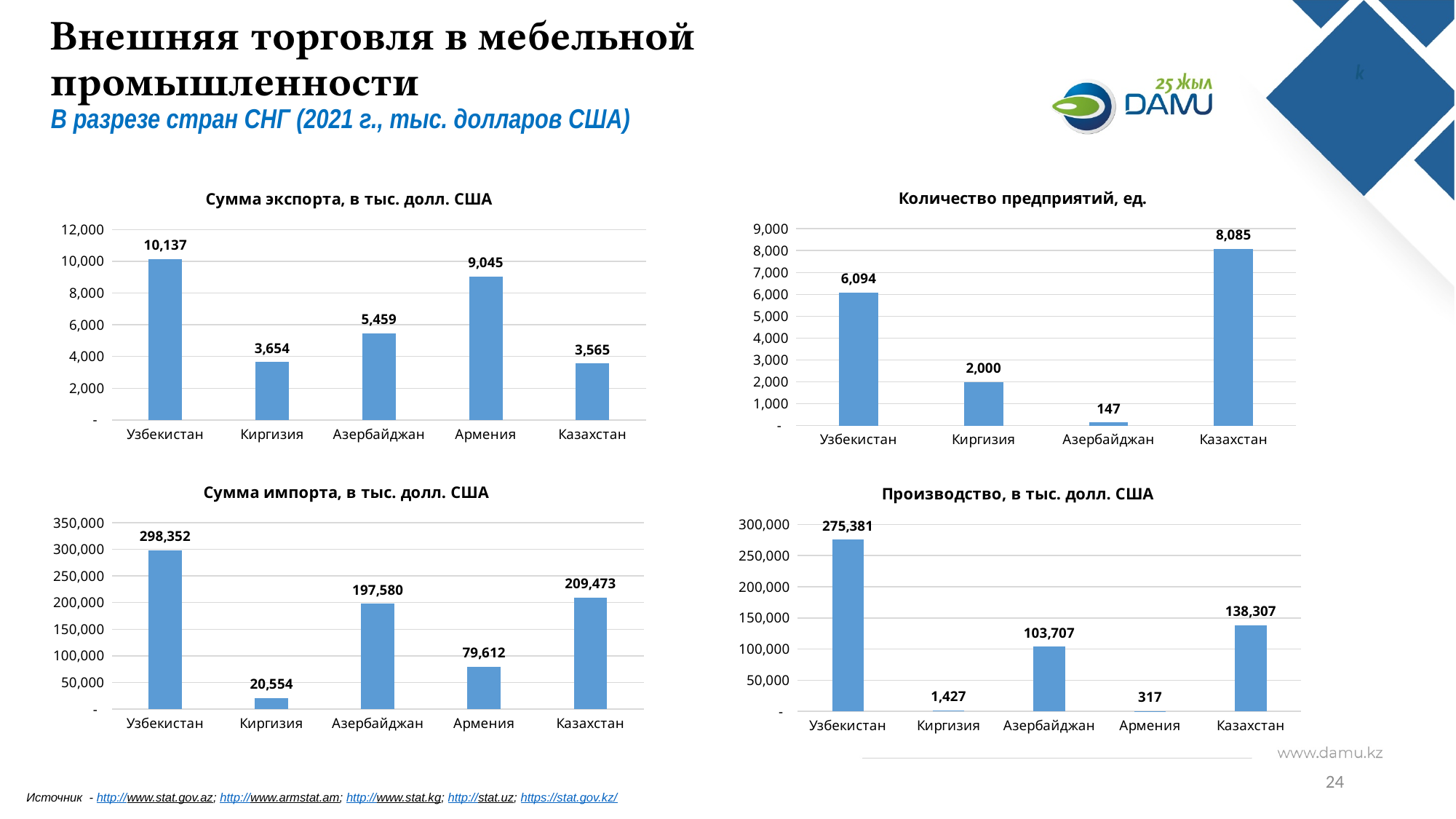
In the chart 'Сумма импорта, в тыс. долл. США', which is larger, the value for Армения or the value for Киргизия? Армения In the chart 'Количество предприятий, ед.', which country has the highest value? Казахстан In the chart 'Сумма импорта, в тыс. долл. США', what is the difference between the values for Казахстан and Азербайджан? 11,893 In the chart 'Сумма экспорта, в тыс. долл. США', is the value for Азербайджан greater or less than 4,000? greater In the chart 'Производство, в тыс. долл. США', which country has the lowest value? Армения In the chart 'Сумма экспорта, в тыс. долл. США', what is the difference between the values for Узбекистан and Армения? 1,092 In the chart 'Сумма экспорта, в тыс. долл. США', what is the value for Армения? 9,045 In the chart 'Производство, в тыс. долл. США', what is the value for Казахстан? 138,307 How many countries are shown in the chart 'Количество предприятий, ед.'? 4 What type of chart is 'Сумма импорта, в тыс. долл. США'? bar chart In the chart 'Сумма экспорта, в тыс. долл. США', which country has the highest value? Узбекистан In the chart 'Количество предприятий, ед.', what is the value for Азербайджан? 147